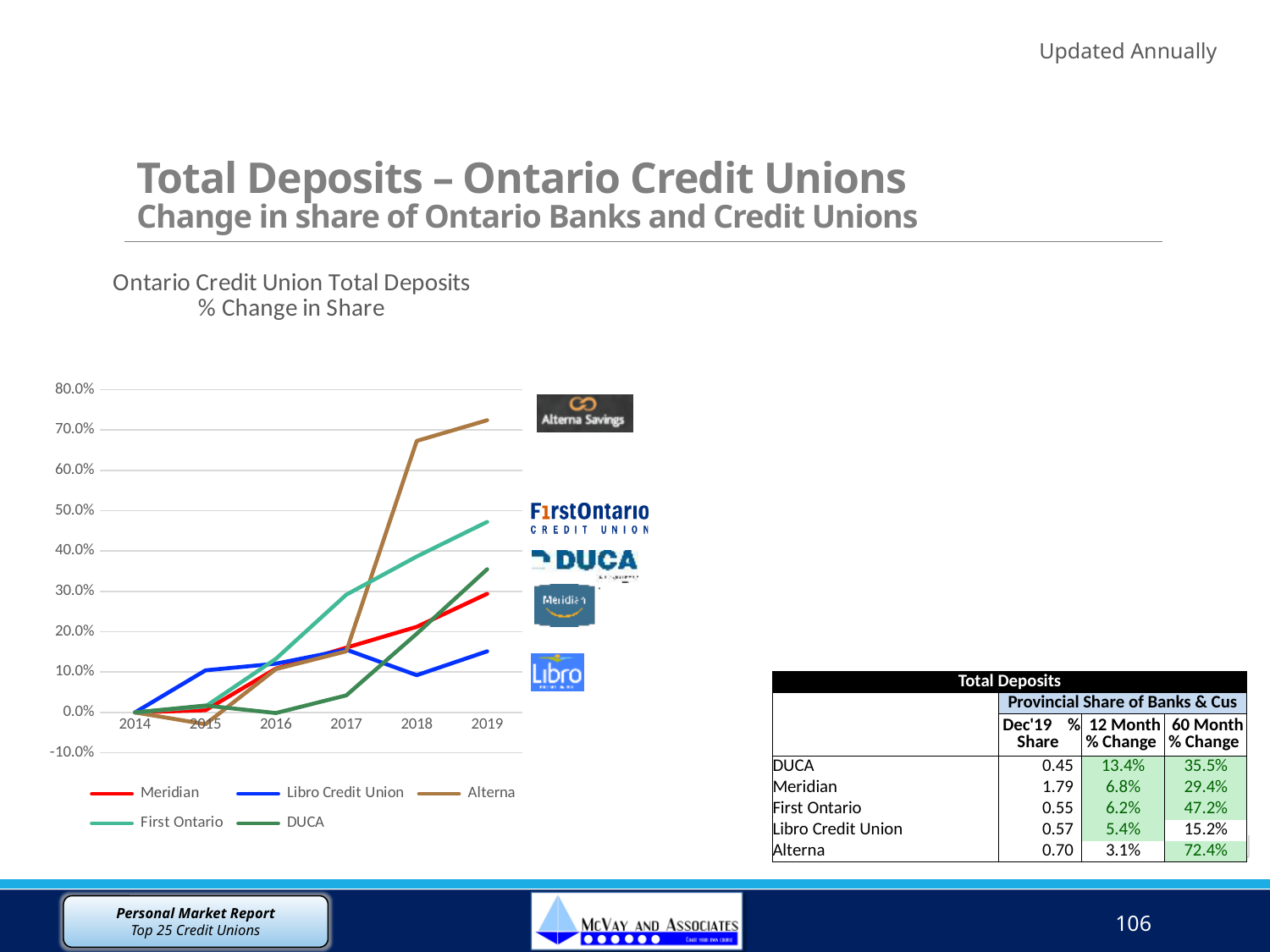
How many series does the chart legend list? 5 Is the value for First Ontario in 2019 greater or less than 40.0%? greater In 2019, which is larger: the value for DUCA or the value for Meridian? DUCA How many years are shown along the x axis of the chart? 6 Is the value for Alterna in 2018 greater or less than 60.0%? greater What kind of chart is shown on the slide? line chart What is the title of the chart? Ontario Credit Union Total Deposits % Change in Share Which series has the lowest value in 2019? Libro Credit Union Is the value for Libro Credit Union in 2019 greater or less than 20.0%? less Does the Alterna line rise or fall between 2016 and 2019? rise Which series has the highest value in 2019? Alterna